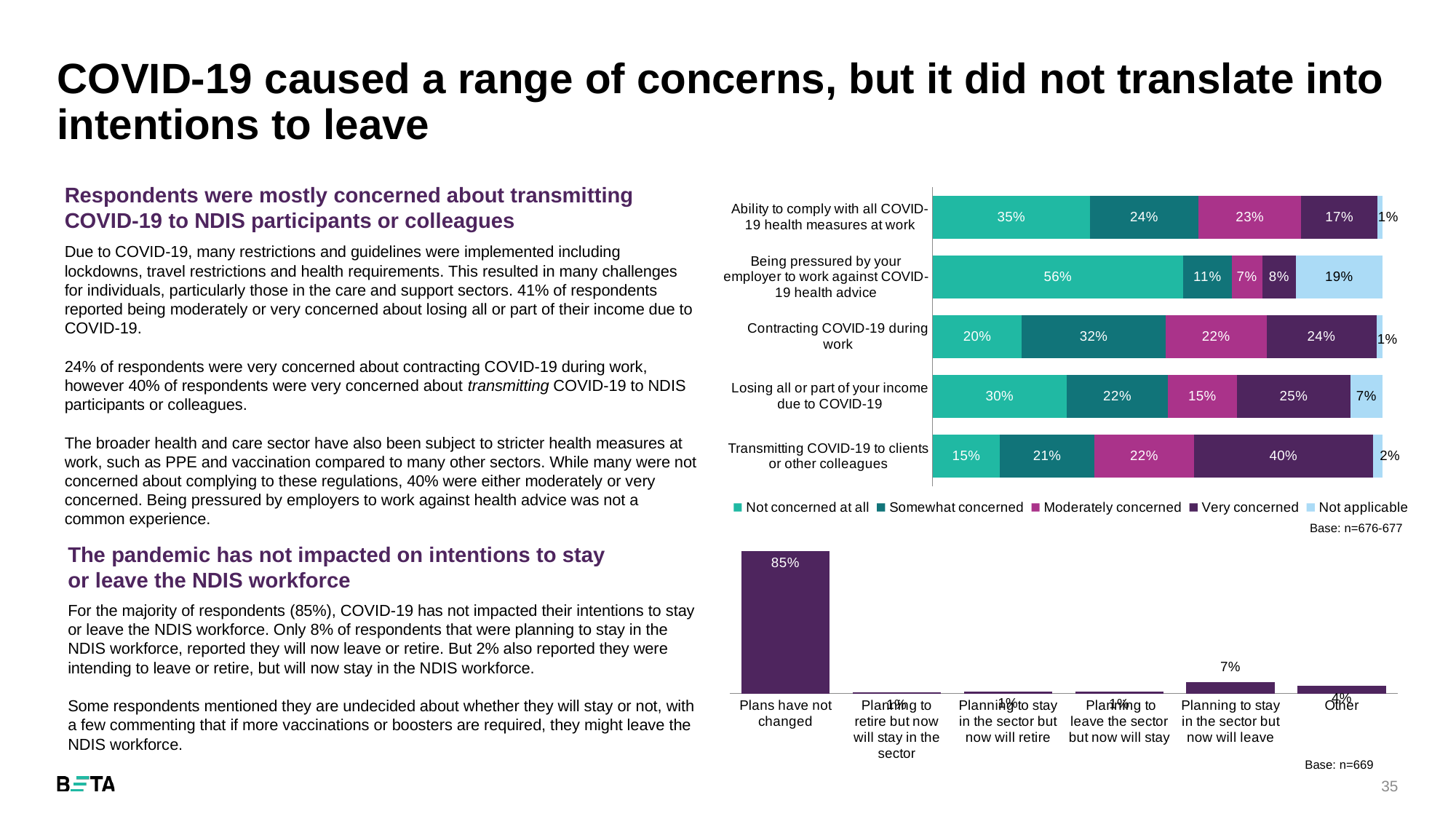
How many concern items are shown in the top chart? 5 In the top chart, which is larger: the 'Moderately concerned' share for ability to comply with all COVID-19 health measures at work, or for losing all or part of your income due to COVID-19? Ability to comply with all COVID-19 health measures at work In the top chart, what percentage of respondents were very concerned about transmitting COVID-19 to clients or other colleagues? 40% In the top chart, what percentage were not concerned at all about being pressured by their employer to work against COVID-19 health advice? 56% In the top chart, which item has the highest 'Very concerned' percentage? Transmitting COVID-19 to clients or other colleagues How many series does the legend of the top chart list? 5 What type of chart is the bottom chart? Bar chart In the bottom chart, what percentage of respondents said their plans have not changed? 85% In the top chart, what is the difference between the 'Very concerned' percentages for contracting COVID-19 during work and transmitting COVID-19 to clients or other colleagues? 16% In the bottom chart, what percentage were planning to stay in the sector but now will leave? 7% In the top chart, which item has the highest 'Not applicable' percentage? Being pressured by your employer to work against COVID-19 health advice In the top chart, what percentage were somewhat concerned about contracting COVID-19 during work? 32%